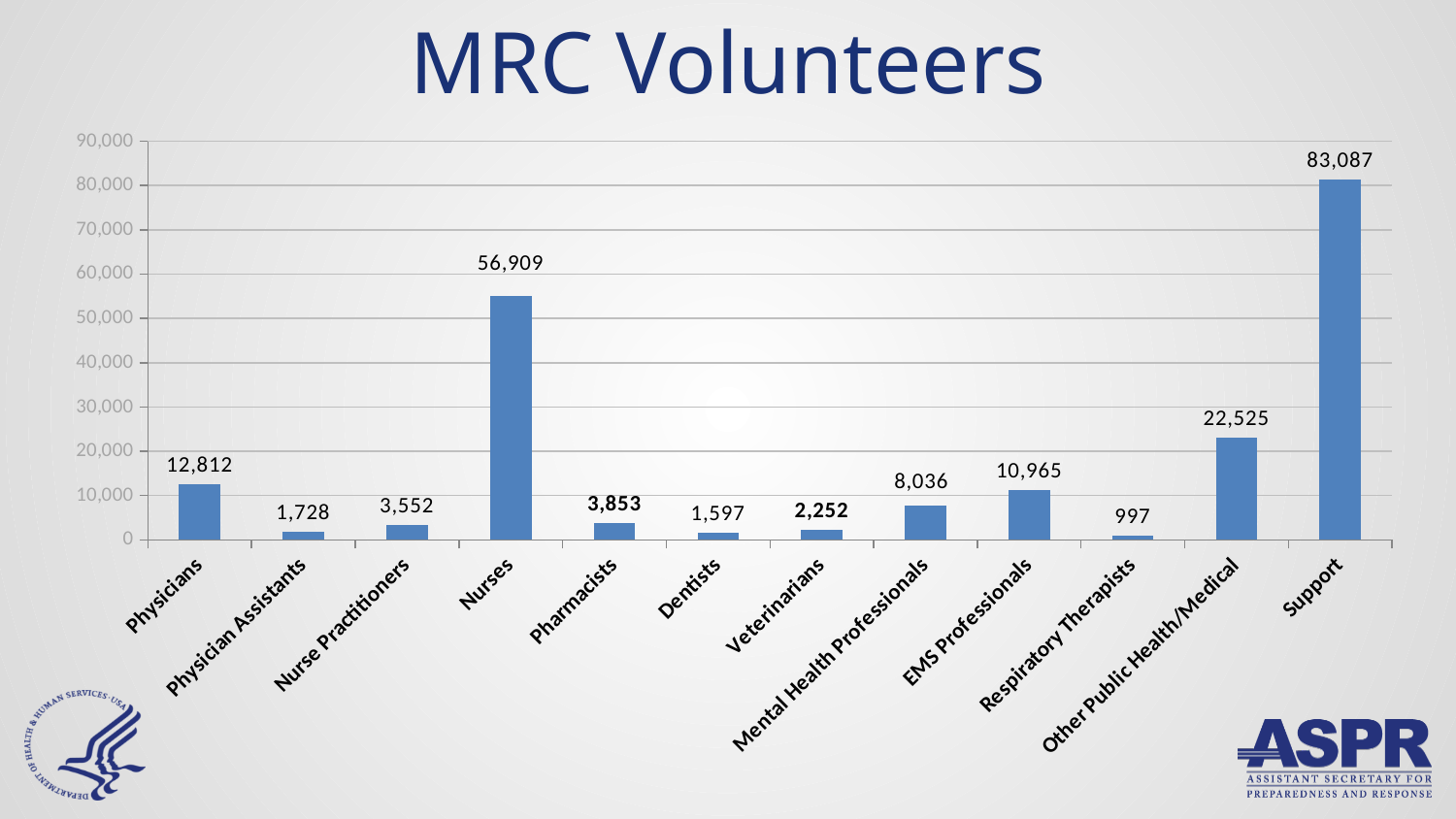
What is the number of MRC volunteers for Nurses? 56,909 What is the number of MRC volunteers for Veterinarians? 2,252 How many categories are shown on the chart? 12 Which category has the lowest number of MRC volunteers? Respiratory Therapists Is the value for Other Public Health/Medical greater or less than 20,000? greater Which has more MRC volunteers, Pharmacists or Nurse Practitioners? Pharmacists What is the number of MRC volunteers for Other Public Health/Medical? 22,525 Which category has the highest number of MRC volunteers? Support What is the difference between the number of volunteers for Physicians and for EMS Professionals? 1,847 What is the number of MRC volunteers for Respiratory Therapists? 997 What is the difference between the number of volunteers for Support and for Nurses? 26,178 What kind of chart is shown on the slide? Bar chart